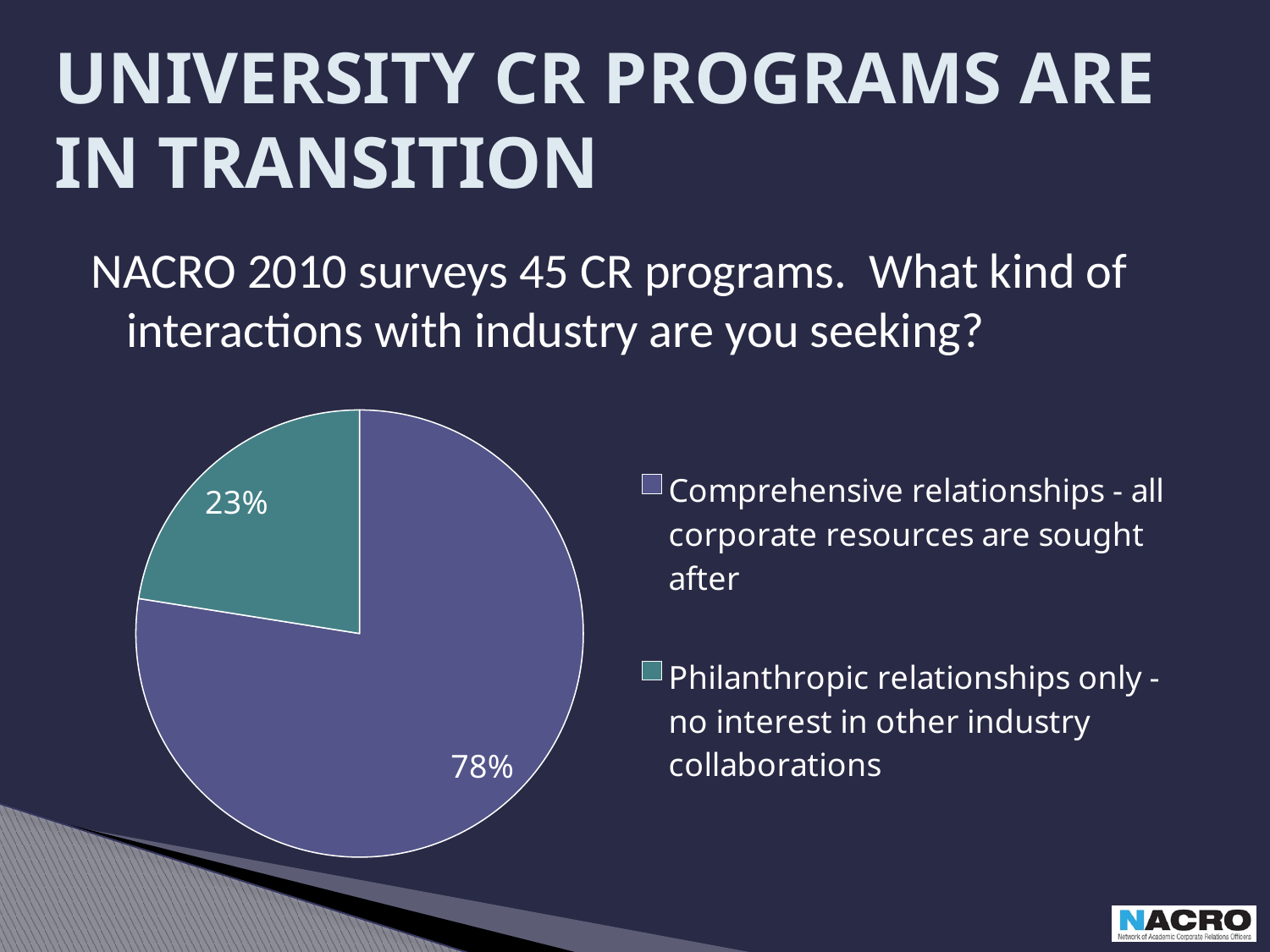
What kind of chart is shown on the slide? pie chart How many slices does the pie chart have? 2 Which category has the smallest slice of the pie? Philanthropic relationships only - no interest in other industry collaborations What is the difference in percentage points between the 'Comprehensive relationships' slice and the 'Philanthropic relationships only' slice? 55 What colour is the slice for 'Philanthropic relationships only - no interest in other industry collaborations'? teal What share of the pie is labelled for 'Philanthropic relationships only - no interest in other industry collaborations'? 23% Which slice is larger: 'Comprehensive relationships' or 'Philanthropic relationships only'? Comprehensive relationships - all corporate resources are sought after How many entries does the legend list? 2 How many CR programs did the NACRO 2010 survey cover, according to the slide text? 45 What share of the pie is labelled for 'Comprehensive relationships - all corporate resources are sought after'? 78% Which category has the largest slice of the pie? Comprehensive relationships - all corporate resources are sought after